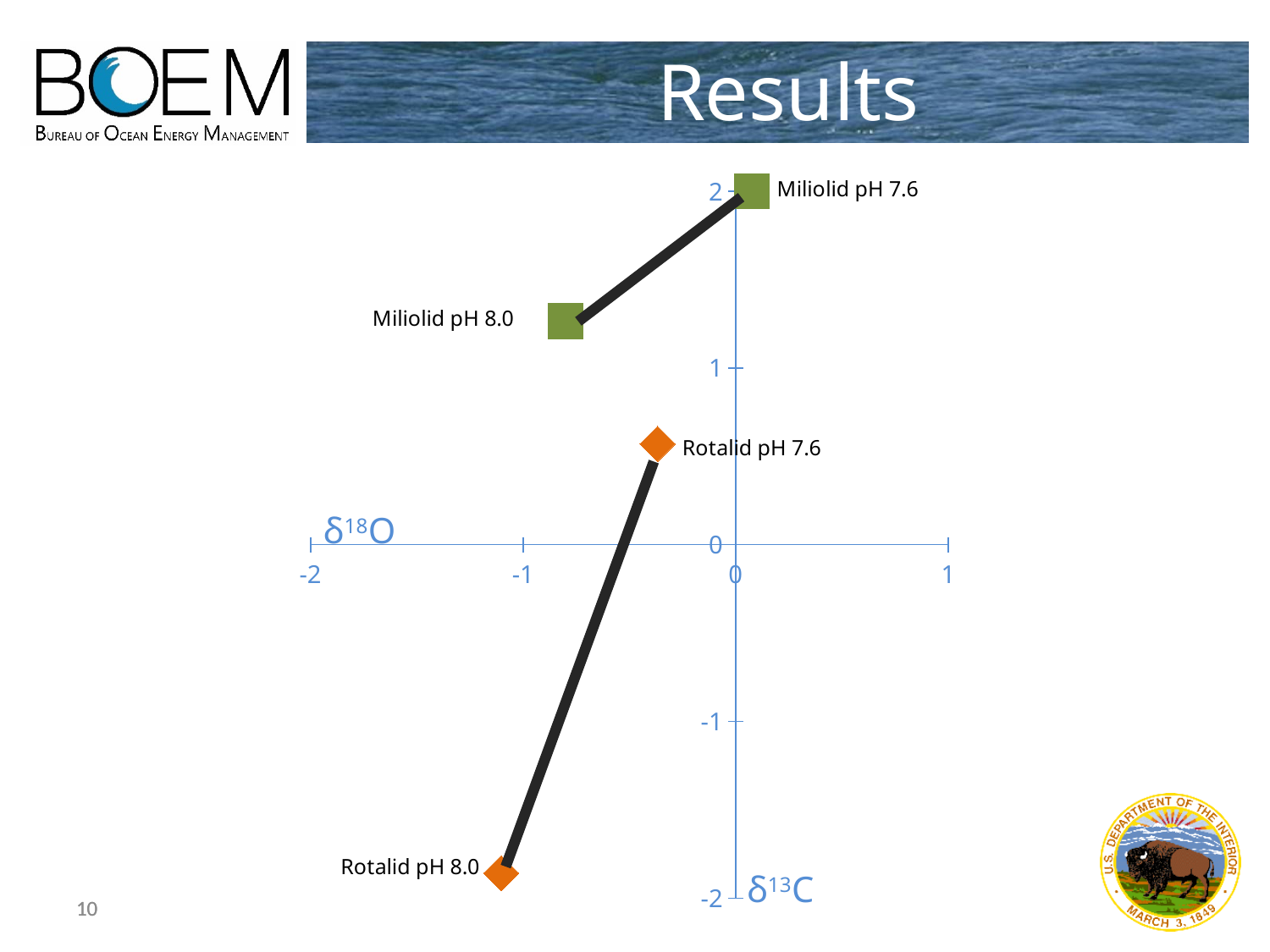
Which has the higher δ13C value, Miliolid pH 8.0 or Rotalid pH 7.6? Miliolid pH 8.0 Is the δ13C value for Miliolid pH 8.0 greater or less than 1? greater Is the δ13C value for Rotalid pH 7.6 greater or less than 0? greater Which labeled point has the lowest δ18O value? Rotalid pH 8.0 Which labeled point has the lowest δ13C value? Rotalid pH 8.0 How many labeled data points are plotted on the chart? 4 What is the label on the horizontal axis of the chart? δ18O Which labeled point has the highest δ13C value? Miliolid pH 7.6 What kind of chart is shown on the slide? scatter chart Is the δ18O value for Miliolid pH 8.0 greater or less than 0? less What marker shape is used for the Rotalid points? diamond